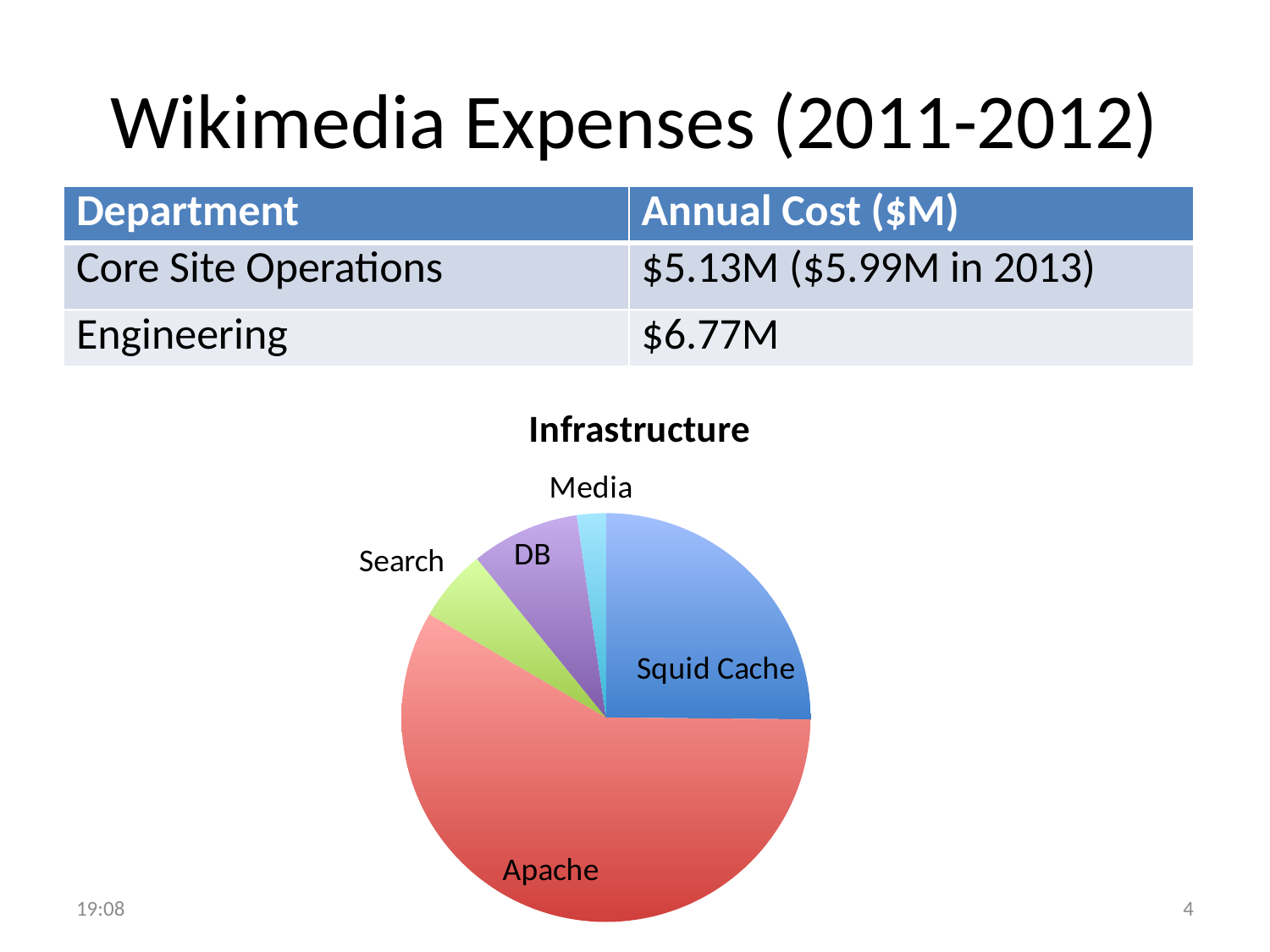
What is the title of the pie chart? Infrastructure Which slice of the Infrastructure pie chart is the smallest? Media Which slice of the Infrastructure pie chart is the second largest? Squid Cache How many slices does the Infrastructure pie chart have? 5 In the Infrastructure pie chart, which is larger, Apache or Squid Cache? Apache In the Infrastructure pie chart, which is larger, Squid Cache or Search? Squid Cache In the Infrastructure pie chart, which is larger, Squid Cache or DB? Squid Cache Which slice of the Infrastructure pie chart is the largest? Apache What kind of chart is shown on the slide? pie chart What colour is the Apache slice in the Infrastructure pie chart? red